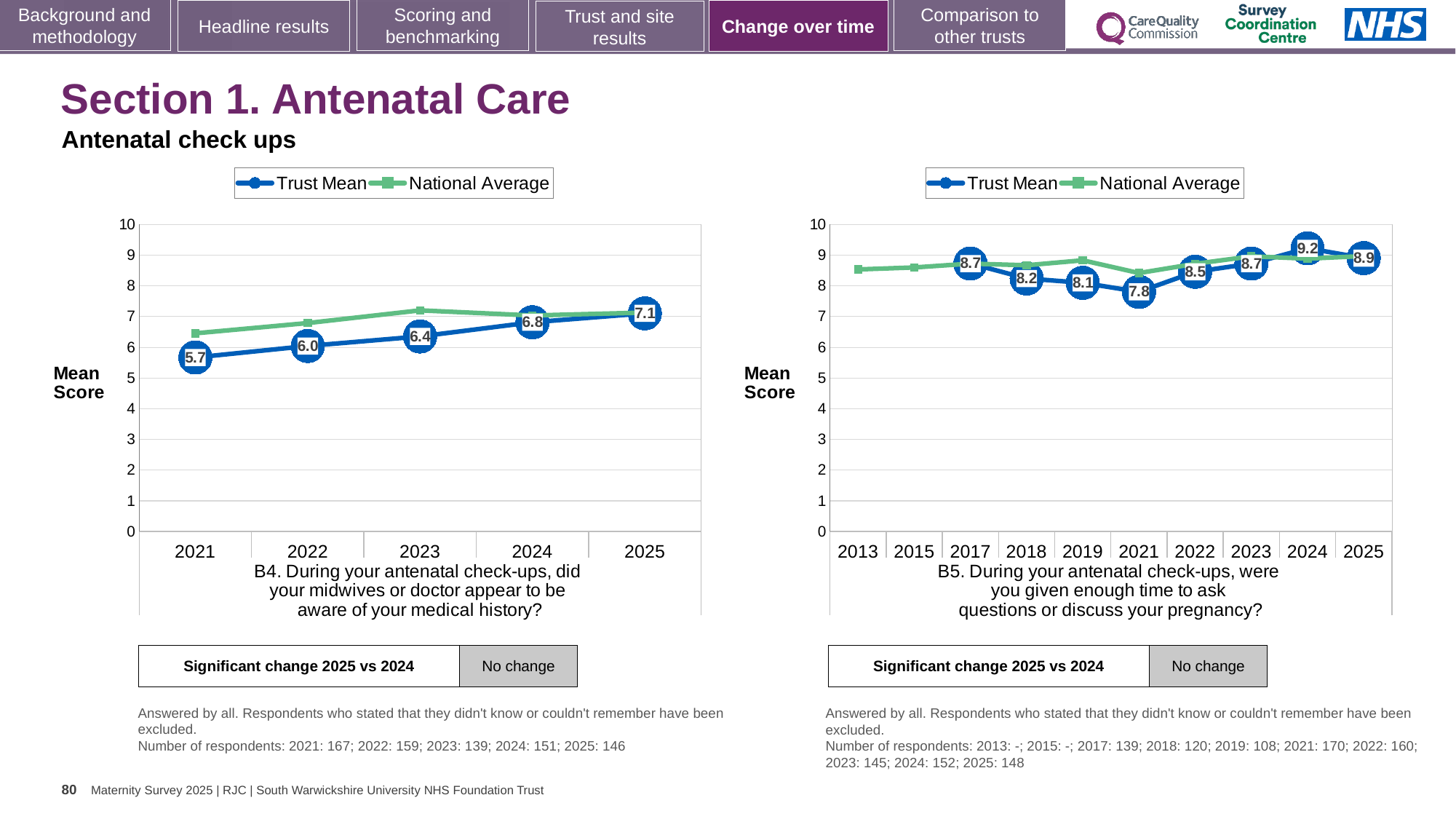
In the left chart (B4), does the Trust Mean rise or fall from 2021 to 2025? rise In the right chart (B5), which year has the highest Trust Mean? 2024 In the right chart (B5), how many years are shown on the x axis? 10 What type of chart is the left chart (B4)? line chart In the left chart (B4), what is the difference between the Trust Mean in 2025 and in 2021? 1.4 In the left chart (B4), which year has the lowest Trust Mean? 2021 In the left chart (B4), what is the Trust Mean for 2021? 5.7 In the right chart (B5), what is the Trust Mean for 2024? 9.2 In the left chart (B4), what is the Trust Mean for 2025? 7.1 In the right chart (B5), which is larger, the Trust Mean for 2018 or for 2022? 2022 In the right chart (B5), what is the Trust Mean for 2021? 7.8 In the left chart (B4), is the National Average for 2021 greater or less than 6? greater